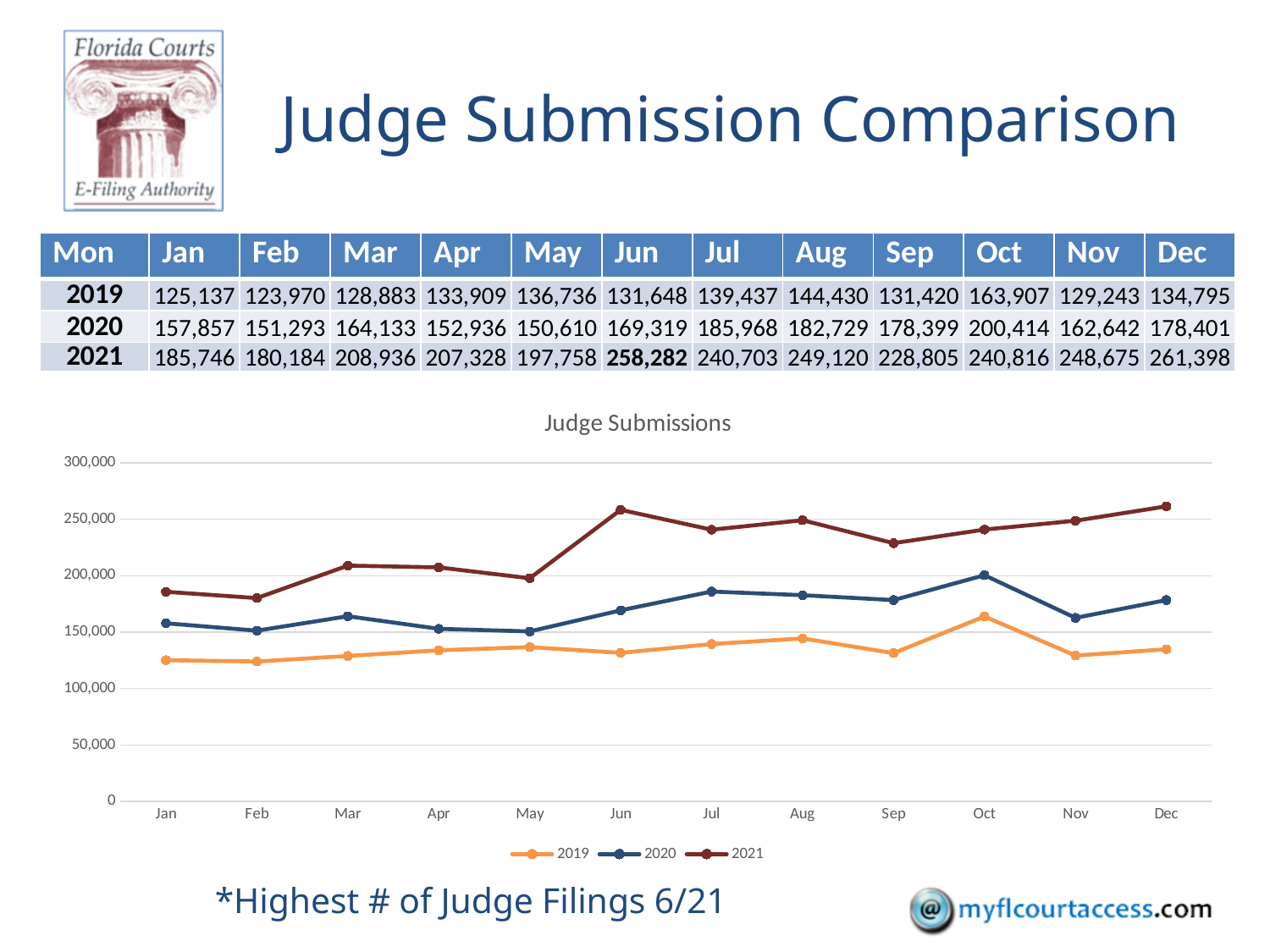
What is the value for 2021 in June? 258,282 In which month is the 2021 series highest? Dec What type of chart is shown on the slide? line chart What is the difference between the 2021 and 2020 values in June? 88,963 In which month is the 2020 series lowest? May What is the value for 2020 in May? 150,610 Is the 2021 value for December greater or less than 250,000? greater What is the value for 2019 in October? 163,907 What is the chart's title? Judge Submissions How many series does the legend list? 3 How many months are plotted along the x axis? 12 Which is larger, the 2020 value in October or the 2019 value in October? 2020